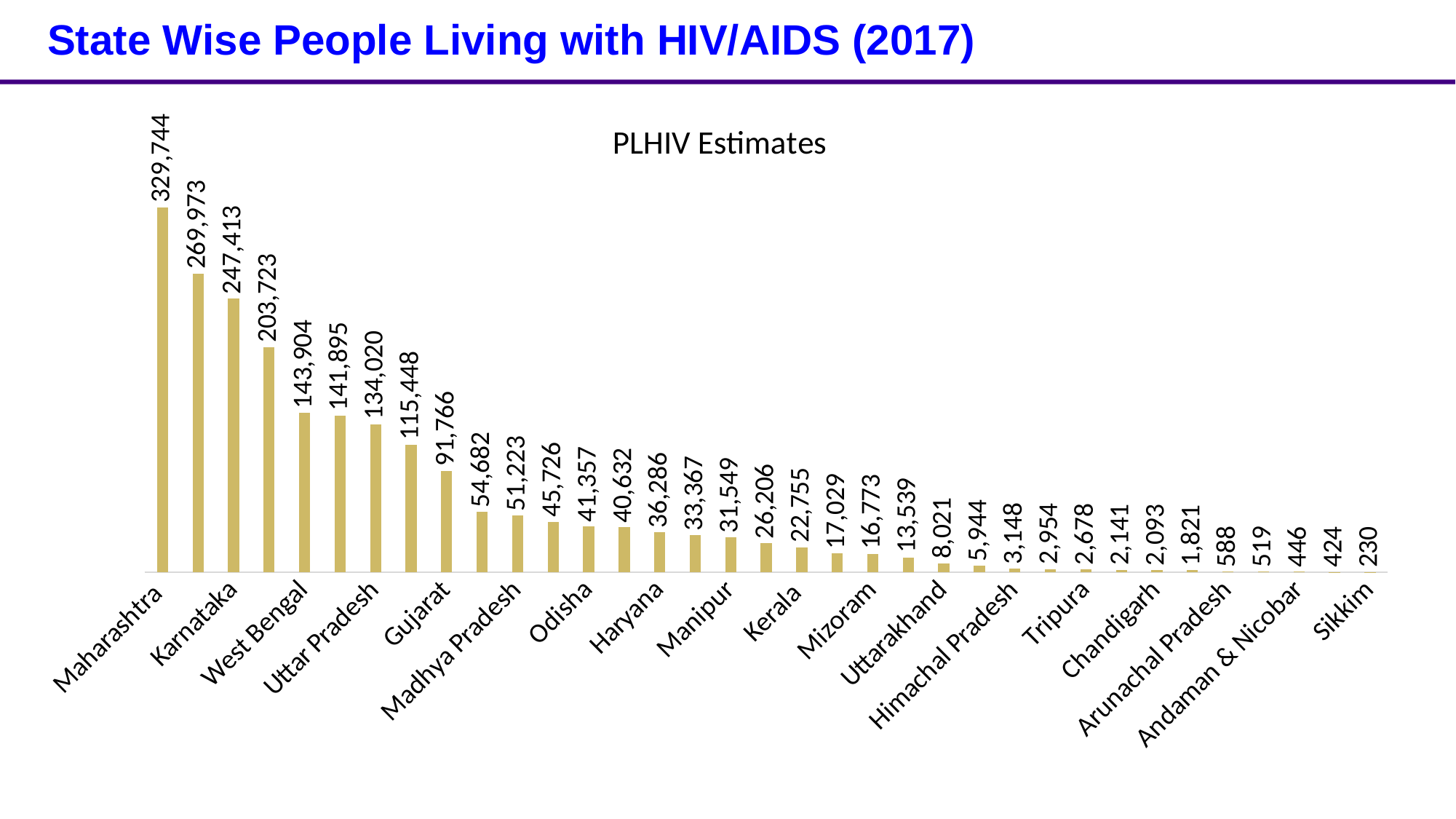
Do the PLHIV estimates rise or fall moving from left to right along the x axis? Fall What is the PLHIV estimate for Maharashtra? 329,744 What is the PLHIV estimate for Kerala? 22,755 What is the difference between the PLHIV estimates for Maharashtra and Karnataka? 82,331 What is the PLHIV estimate for Gujarat? 91,766 What is the PLHIV estimate for Sikkim? 230 Which state has the highest PLHIV estimate? Maharashtra What is the PLHIV estimate for Karnataka? 247,413 Which has a larger PLHIV estimate, West Bengal or Uttar Pradesh? West Bengal What is the title shown above the chart? PLHIV Estimates What type of chart is shown on the slide? Bar chart Which state has the lowest PLHIV estimate? Sikkim